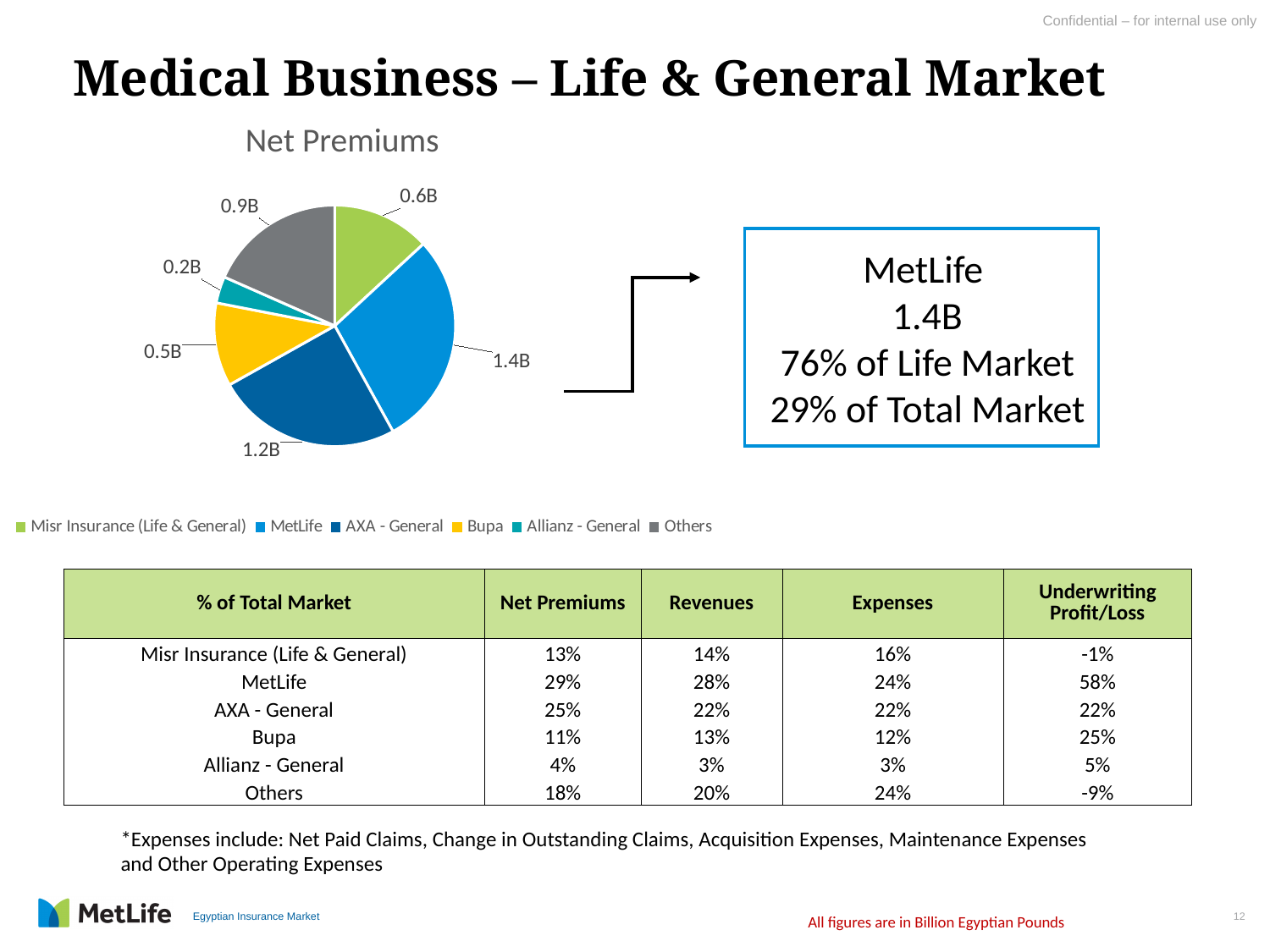
How many slices does the Net Premiums pie chart have? 6 In the Net Premiums pie chart, which is larger: Others or Misr Insurance (Life & General)? Others What is the title of the chart on the slide? Net Premiums What kind of chart is used to show Net Premiums on the slide? Pie chart In the Net Premiums pie chart, what is the value for Allianz - General? 0.2B In the Net Premiums pie chart, what is the value for Bupa? 0.5B In the Net Premiums pie chart, what is the value for AXA - General? 1.2B In the Net Premiums pie chart, what is the difference between the MetLife value and the AXA - General value? 0.2B In the Net Premiums pie chart, what is the value for MetLife? 1.4B Which company has the largest slice in the Net Premiums pie chart? MetLife Which company has the smallest slice in the Net Premiums pie chart? Allianz - General In the Net Premiums pie chart, what is the value for Misr Insurance (Life & General)? 0.6B